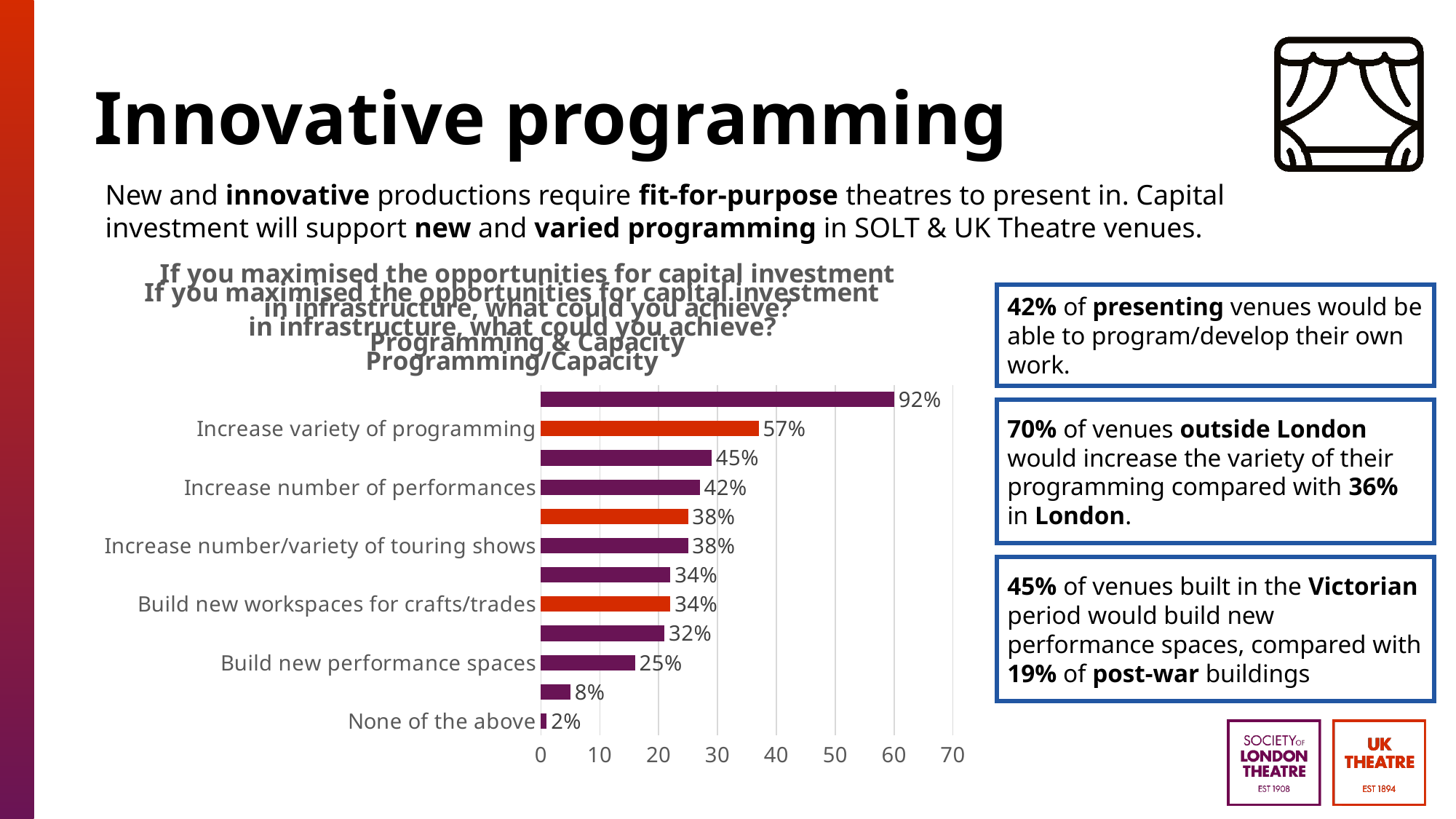
What is the largest tick value shown on the horizontal axis of the chart? 70 What is the value for 'Increase number of performances'? 42% Which is larger, the value for 'Increase variety of programming' or the value for 'Build new performance spaces'? Increase variety of programming What is the value for 'Increase variety of programming'? 57% What is the highest value shown by any bar in the chart? 92% What is the value for 'Build new performance spaces'? 25% What is the lowest value shown by any bar in the chart? 2% What is the difference between the value for 'Increase variety of programming' (57%) and the value for 'Increase number of performances' (42%)? 15% What kind of chart is shown on the slide? bar chart What is the value for 'None of the above'? 2% What is the difference between the highest bar value (92%) and the lowest bar value (2%)? 90% How many bars are plotted in the chart? 12